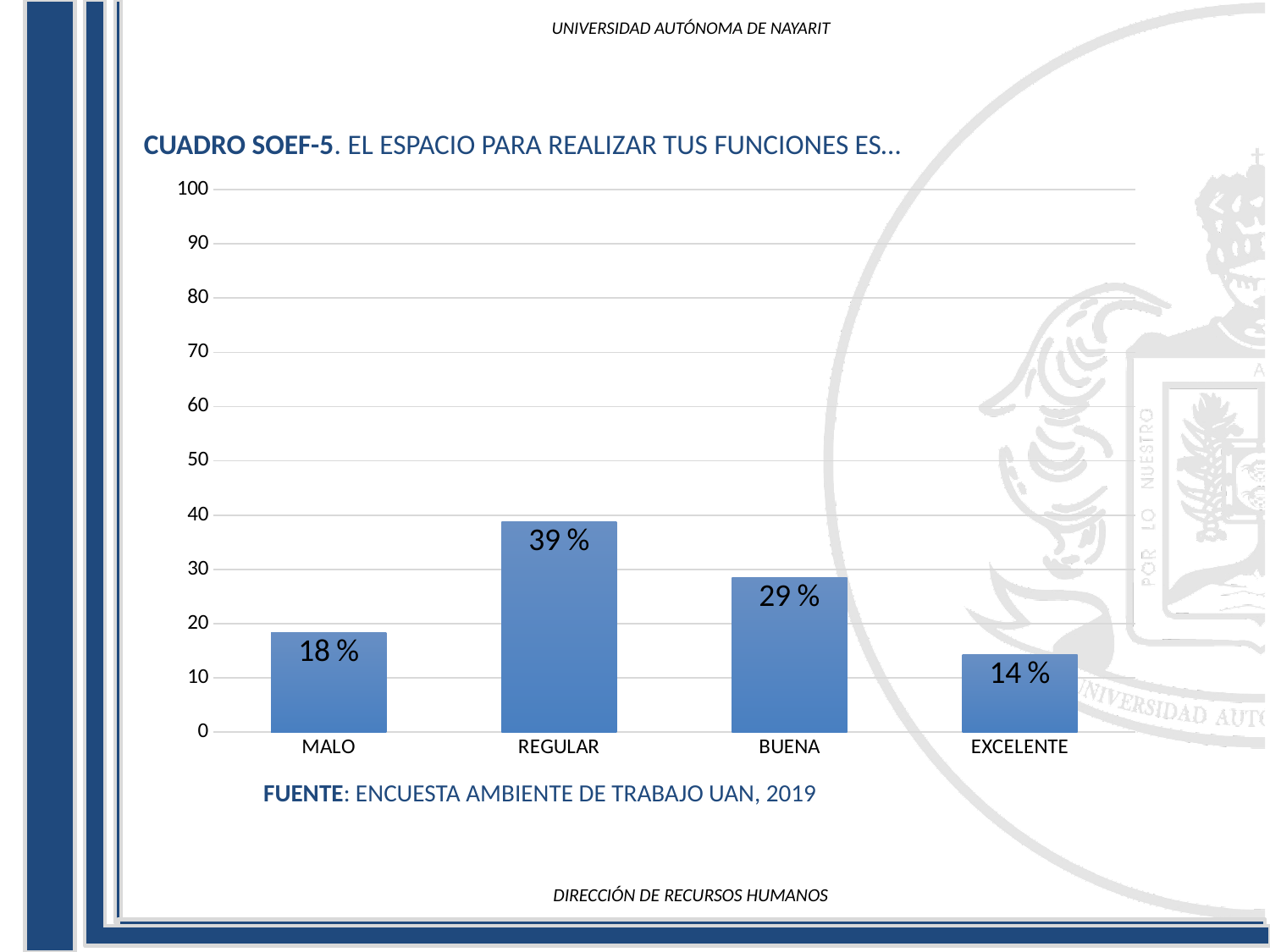
Which category has the highest value? REGULAR Is the value for BUENA greater or less than 40? less What kind of chart is shown on the slide? bar chart What is the value for EXCELENTE? 14 % What is the difference between the values for REGULAR and BUENA? 10 % What is the maximum value shown on the y axis? 100 What is the value for MALO? 18 % What is the value for REGULAR? 39 % What source is cited below the chart? ENCUESTA AMBIENTE DE TRABAJO UAN, 2019 How many categories are shown on the x axis? 4 Which is larger, the value for MALO or the value for BUENA? BUENA Which category has the lowest value? EXCELENTE